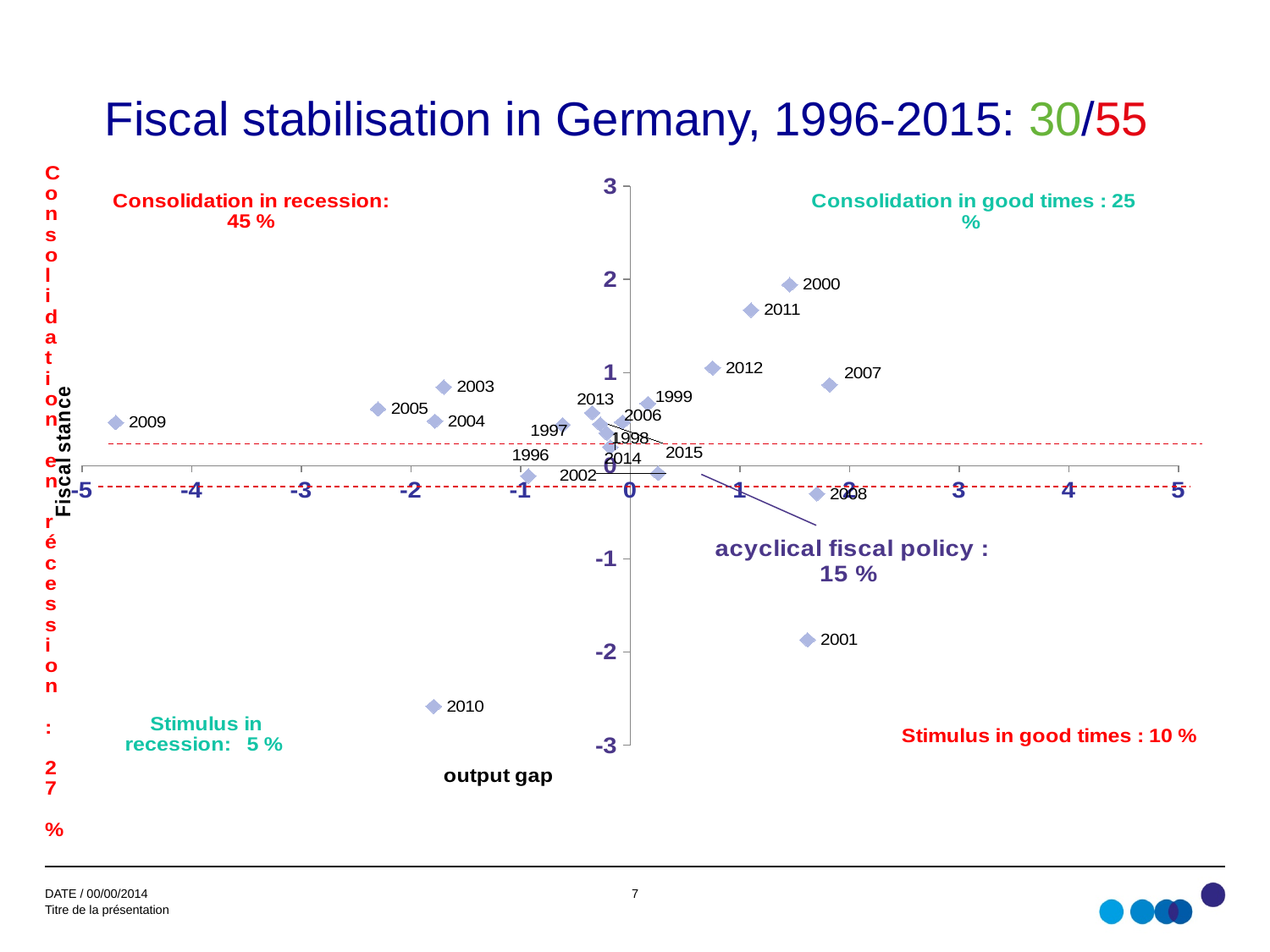
What is the label of the horizontal axis? output gap Which year has the larger fiscal stance value, 2000 or 2001? 2000 Which year has the lowest fiscal stance value on the chart? 2010 What percentage is given for 'Consolidation in recession' on the chart? 45 % Is the fiscal stance value for 2010 greater or less than -2? less Is the fiscal stance value for 2000 greater or less than 1? greater Which year has the highest fiscal stance value on the chart? 2000 Which year has the lowest output gap value on the chart? 2009 Is the fiscal stance value for 2001 greater or less than -1? less How many data points (years) are plotted on the chart? 20 What kind of chart is shown on the slide? scatter chart